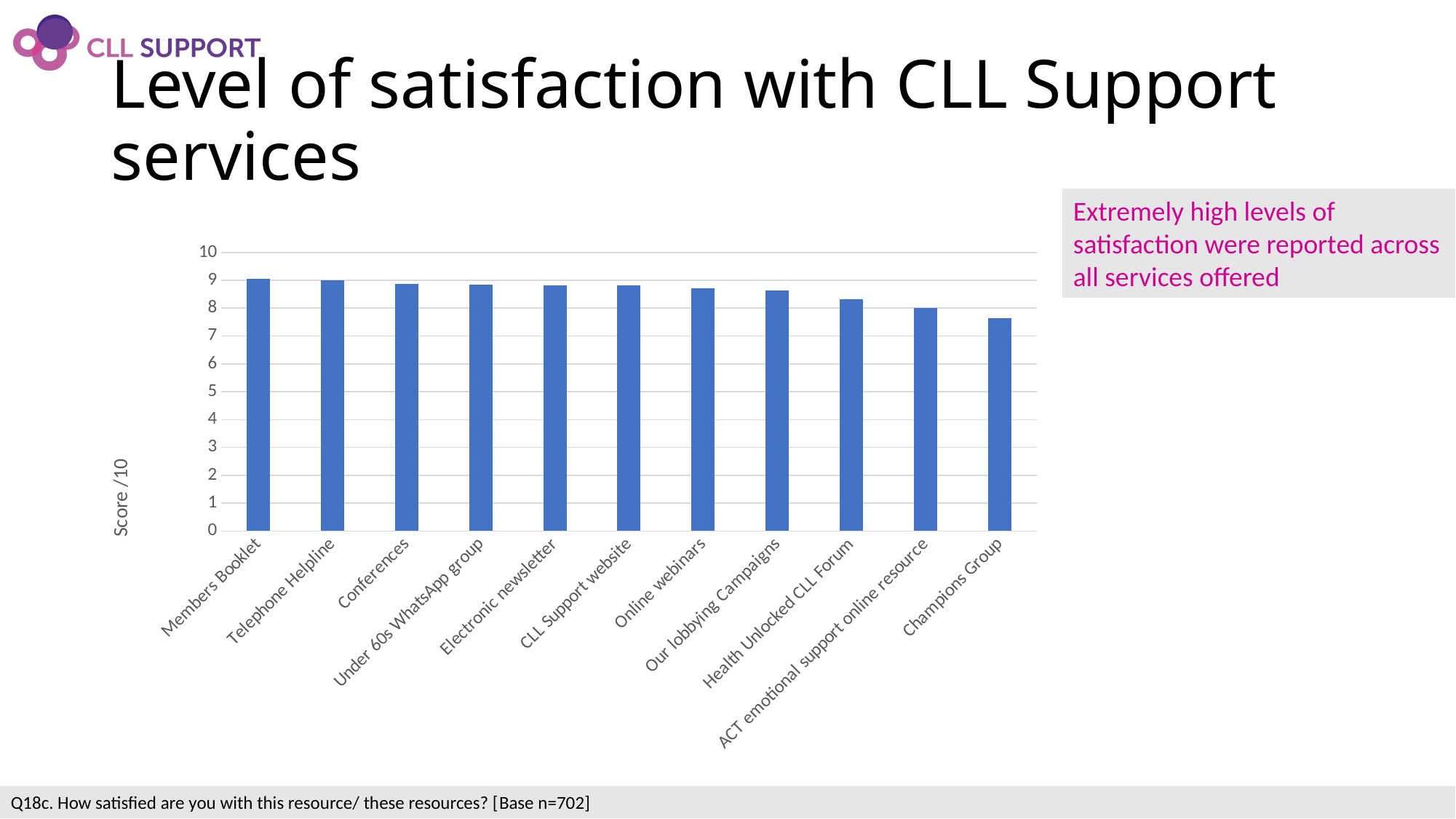
Is the value for Health Unlocked CLL Forum greater or less than 8? greater What is the label on the vertical axis of the chart? Score /10 Is the value for Champions Group greater or less than 8? less Which has the higher satisfaction score, Health Unlocked CLL Forum or ACT emotional support online resource? Health Unlocked CLL Forum What kind of chart is shown on the slide? bar chart Which has the higher satisfaction score, Members Booklet or Champions Group? Members Booklet Is the value for ACT emotional support online resource greater or less than 7? greater Which service has the lowest satisfaction score? Champions Group Do the satisfaction scores rise or fall moving from left to right along the x axis? fall How many services are plotted on the chart? 11